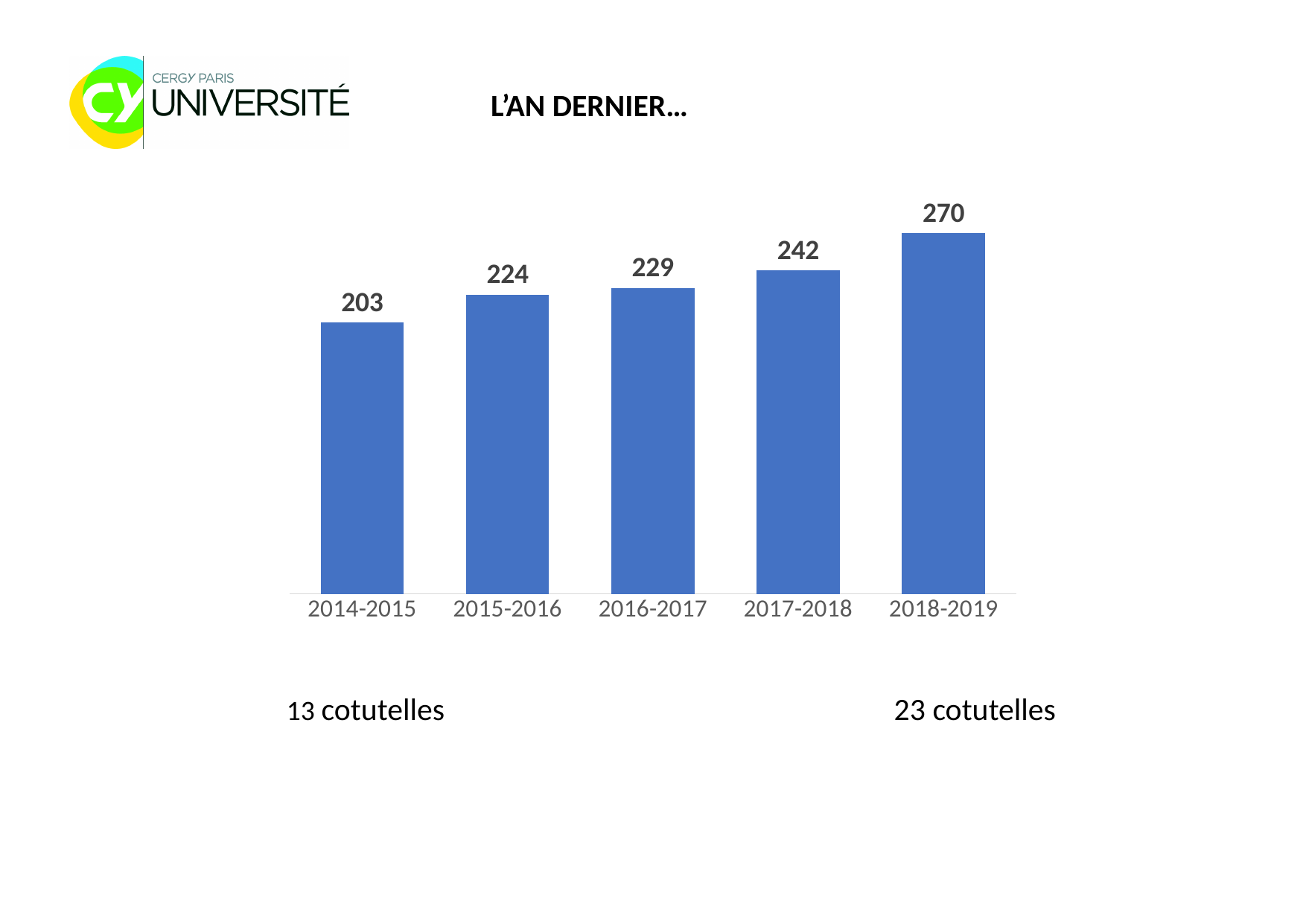
Which is larger, the value for 2015-2016 or the value for 2017-2018? 2017-2018 How many years are shown on the x axis? 5 Which year has the highest value? 2018-2019 What is the value for 2018-2019? 270 What is the difference between the values for 2017-2018 and 2016-2017? 13 What kind of chart is shown on the slide? bar chart What colour are the bars in the chart? blue Which year has the lowest value? 2014-2015 What is the value for 2016-2017? 229 What is the difference between the values for 2018-2019 and 2014-2015? 67 What is the value for 2014-2015? 203 Do the values rise or fall from 2014-2015 to 2018-2019? rise